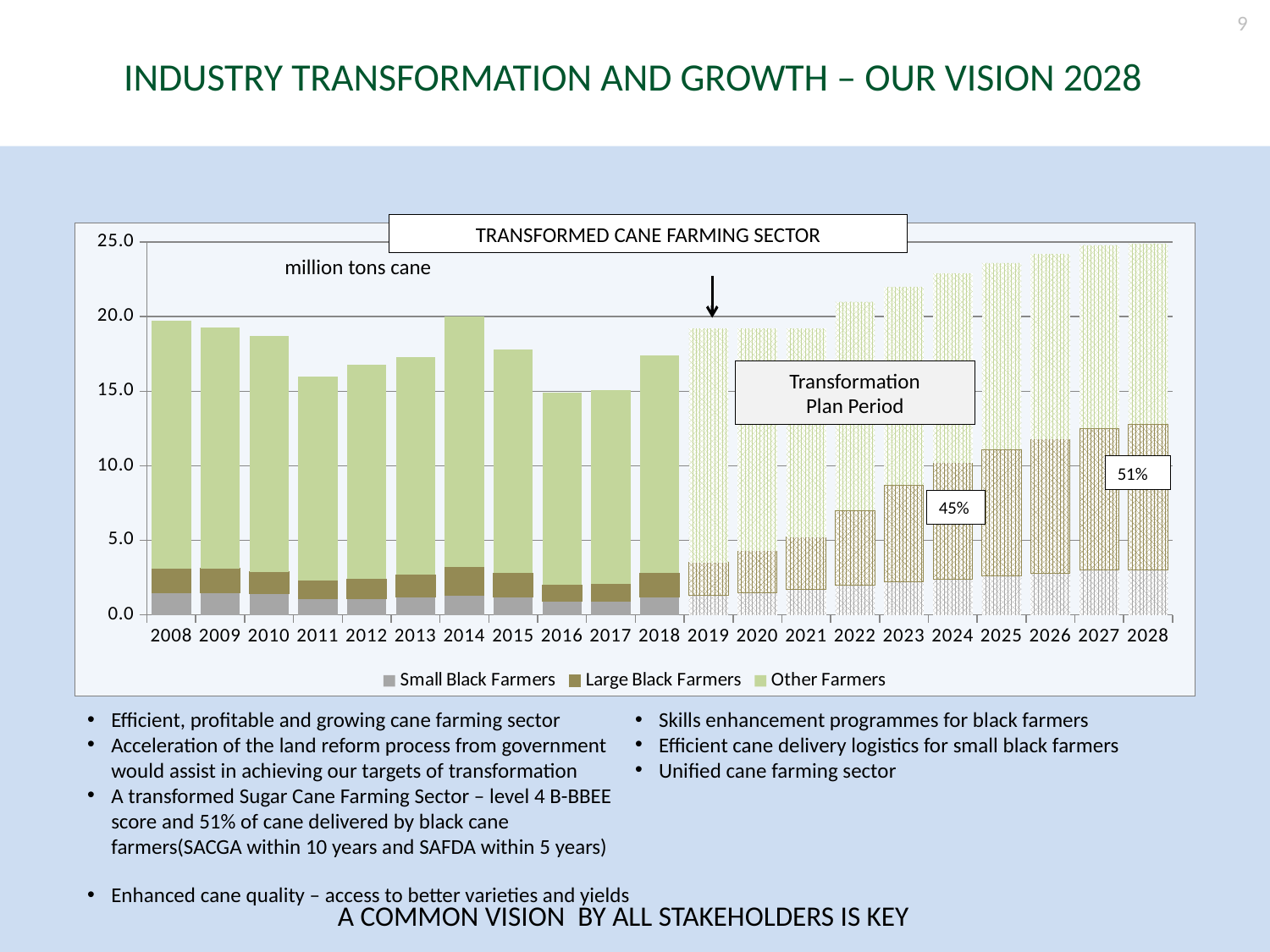
What kind of chart is shown on the slide? stacked bar chart What unit is stated for the values plotted in the chart? million tons cane Is the total value for 2024 greater or less than 20.0? greater How many years are shown along the x axis of the chart? 21 How many series does the chart legend list? 3 Is the total value for 2018 greater or less than 15.0? greater Which year has the larger total bar, 2014 or 2016? 2014 What is the title shown in the box above the chart? TRANSFORMED CANE FARMING SECTOR Is the total value for 2022 greater or less than 20.0? greater Do the total bar values rise or fall from 2019 to 2028? rise Do the total bar values rise or fall from 2008 to 2011? fall